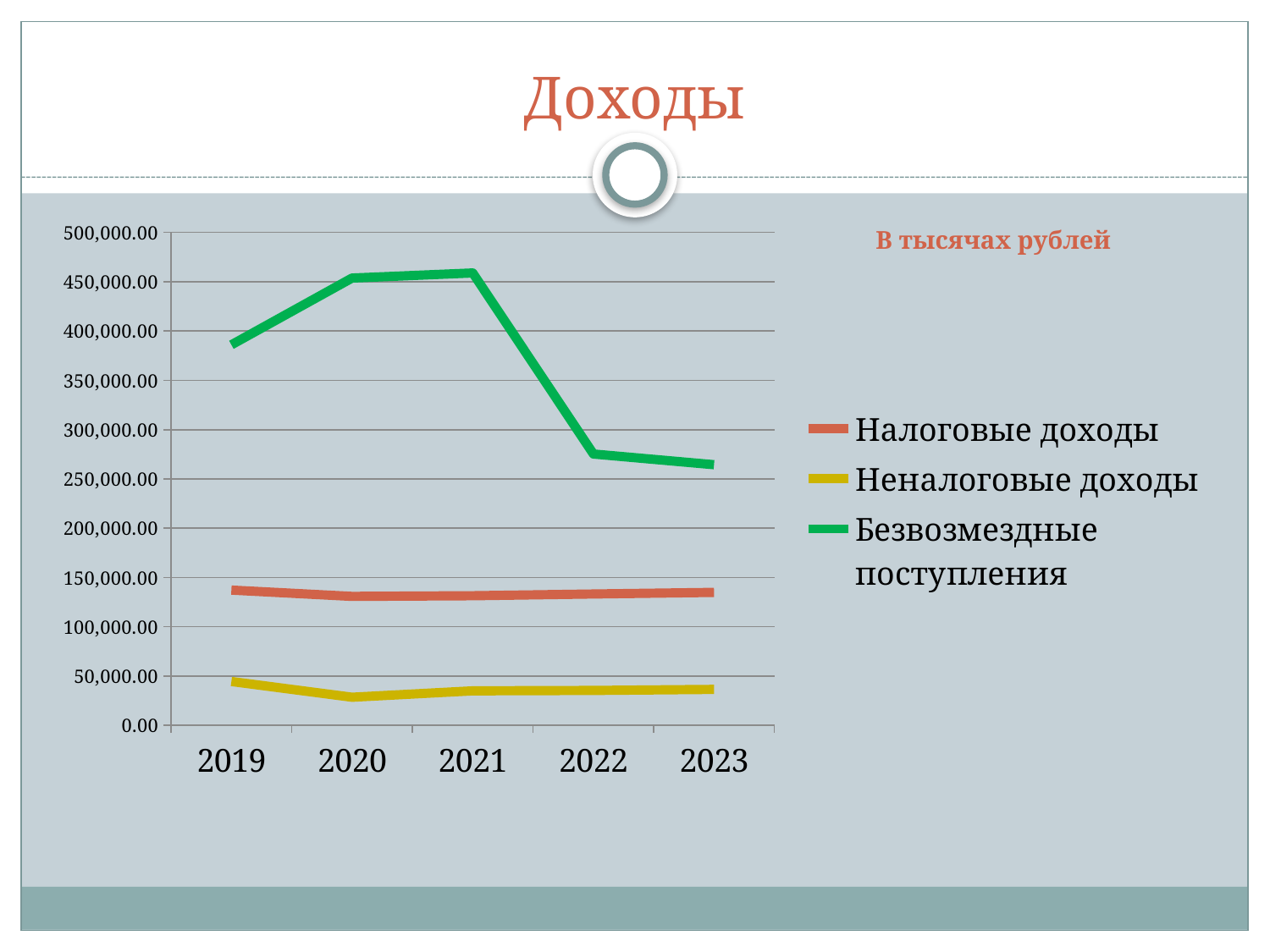
What kind of chart is shown on the slide? line chart What is the title of the chart? Доходы How many series does the legend list? 3 Is the value for Налоговые доходы in 2019 greater or less than 150,000.00? less Is the value for Неналоговые доходы in 2020 greater or less than 50,000.00? less Is the value for Безвозмездные поступления in 2022 greater or less than 300,000.00? less Does the Безвозмездные поступления line rise or fall from 2021 to 2023? fall Which is larger for Безвозмездные поступления: the value in 2019 or the value in 2022? 2019 How many years are shown on the x axis? 5 Which series has the lowest values across all years? Неналоговые доходы Which series has the highest values across all years? Безвозмездные поступления